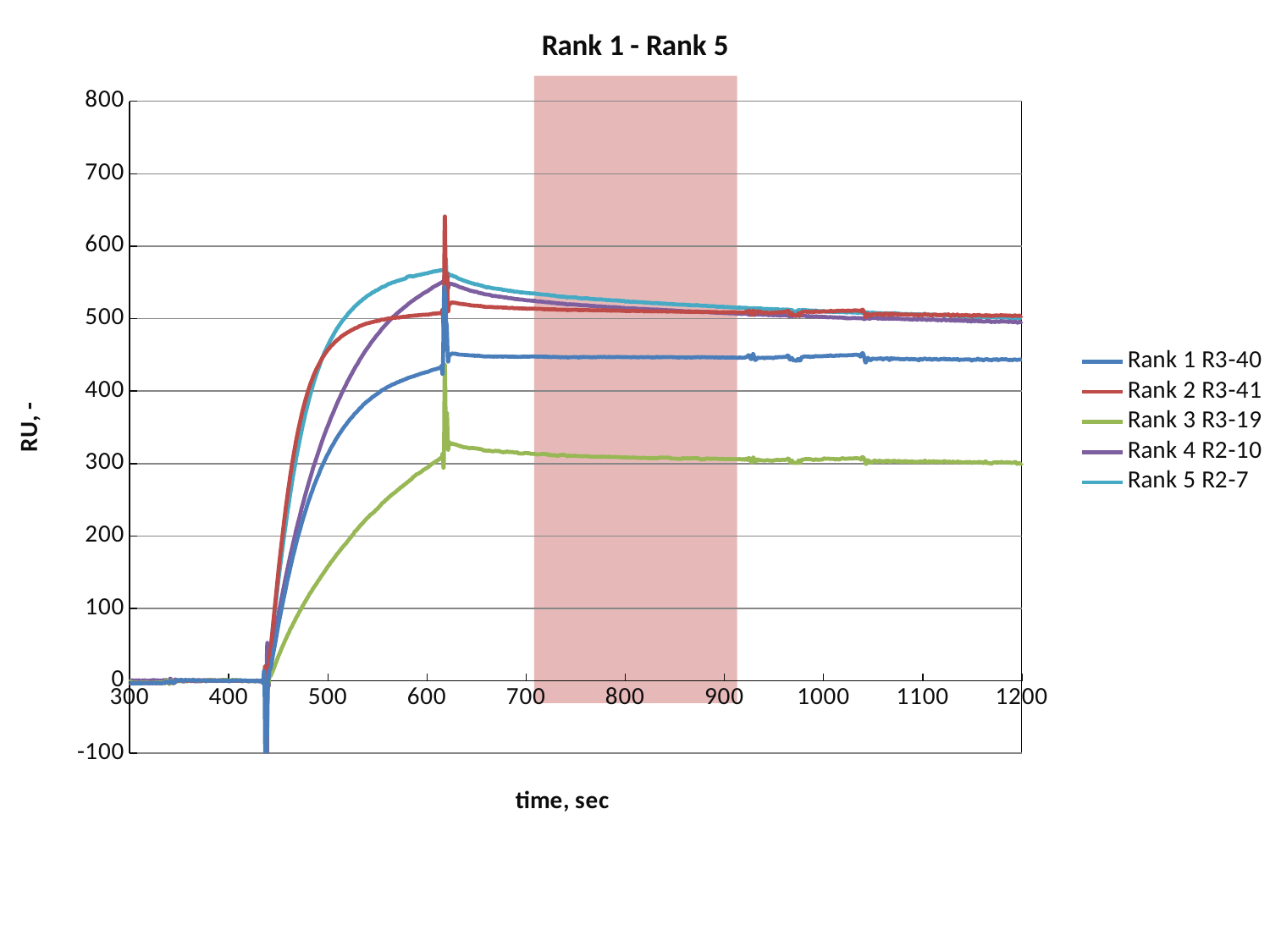
Is the value for Rank 3 R3-19 at time 1000 greater or less than 400? less How many series does the legend list? 5 At time 550, which is larger: Rank 5 R2-7 or Rank 1 R3-40? Rank 5 R2-7 Is the value for Rank 2 R3-41 at time 500 greater or less than 400? greater Is the value for Rank 5 R2-7 at time 600 greater or less than 500? greater What kind of chart is shown on the slide? line chart Which series has the lowest value at time 1000? Rank 3 R3-19 What is the title of the chart? Rank 1 - Rank 5 Does the Rank 3 R3-19 line rise or fall between time 450 and time 600? rise At time 1000, which is larger: Rank 1 R3-40 or Rank 3 R3-19? Rank 1 R3-40 What is the label of the x axis? time, sec